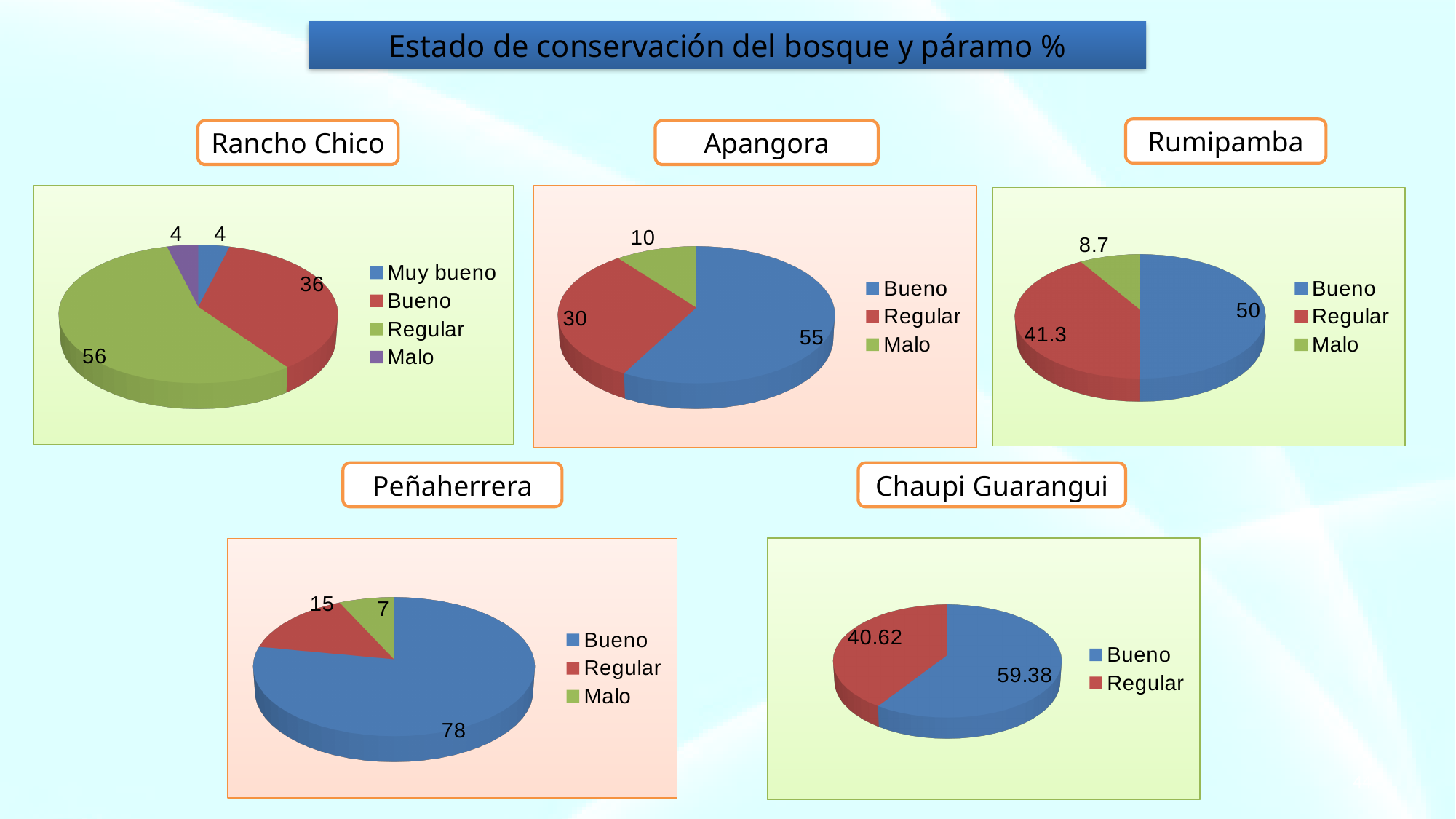
In the Peñaherrera chart, which category has the smallest slice? Malo What kind of chart is used for Rumipamba? Pie chart How many slices does the Chaupi Guarangui chart have? 2 How many categories does the Rancho Chico chart's legend list? 4 In the Chaupi Guarangui chart, what is the difference between Bueno and Regular? 18.76 In the Rumipamba chart, what is the value for Regular? 41.3 What is the title shown at the top of the slide? Estado de conservación del bosque y páramo % In the Apangora chart, what is the value for Malo? 10 In the Apangora chart, which is larger, Bueno or Regular? Bueno In the Rancho Chico chart, what is the value for Regular? 56 In the Peñaherrera chart, which category has the largest slice? Bueno In the Rancho Chico chart, what is the value for Bueno? 36